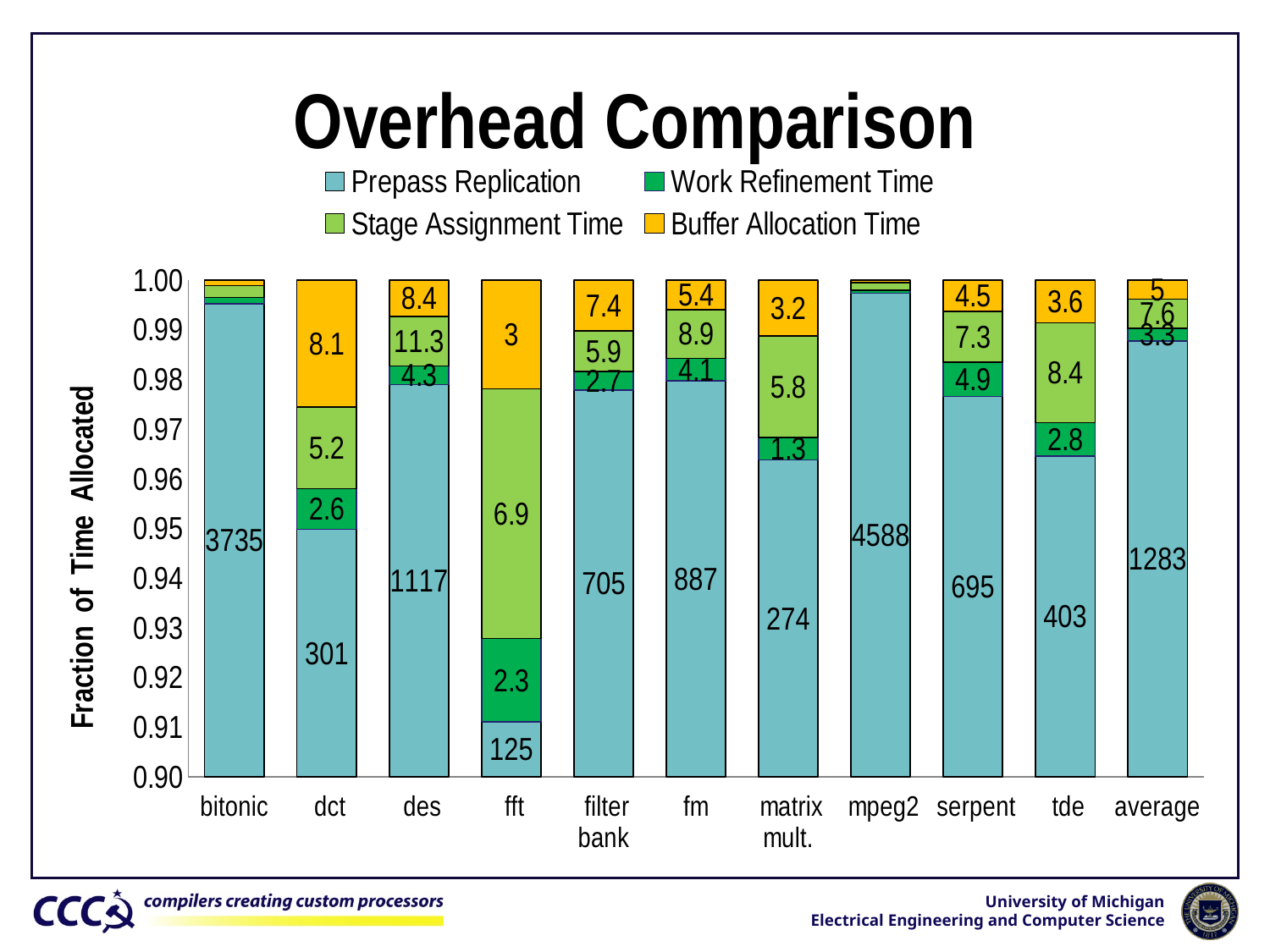
What value is labelled on the Buffer Allocation Time segment for des? 8.4 What value is labelled on the Stage Assignment Time segment for fft? 6.9 How many series does the legend list? 4 Which has the larger labelled Buffer Allocation Time value, dct or fm? dct Which category has the largest labelled Prepass Replication value? mpeg2 How many categories are shown along the x axis? 11 What value is labelled on the Prepass Replication segment for mpeg2? 4588 What kind of chart is shown on the slide? stacked bar chart Is the top of the Prepass Replication segment for fft greater or less than 0.92 on the y axis? less What is the difference between the labelled Prepass Replication values for bitonic and des? 2618 Which category has the smallest labelled Prepass Replication value? fft What value is labelled on the Work Refinement Time segment for serpent? 4.9